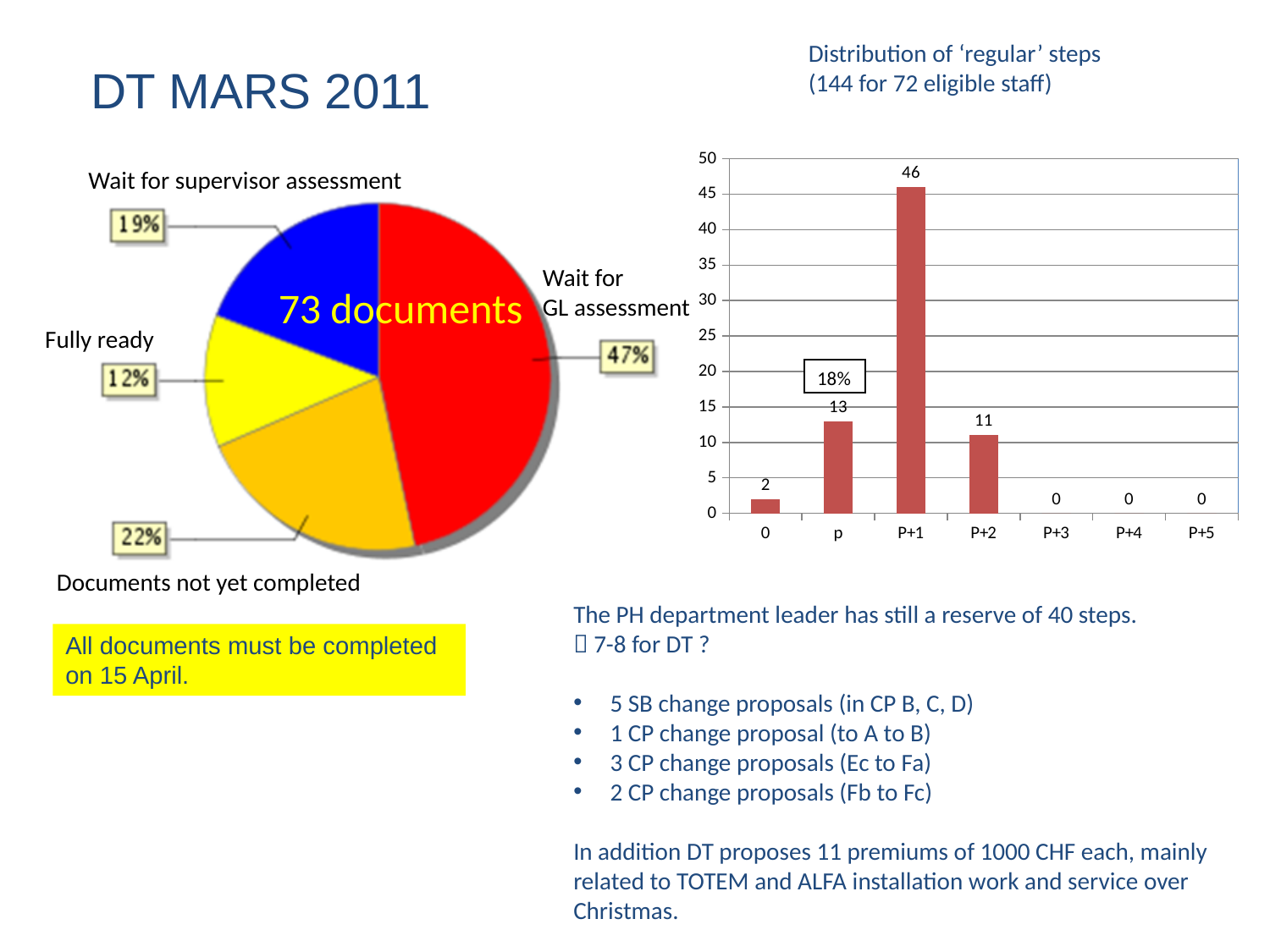
In the pie chart on the left, which category has the smallest share? Fully ready In the bar chart titled 'Distribution of regular steps', which is larger, the value for p or the value for P+2? p In the bar chart titled 'Distribution of regular steps', what is the difference between the values for P+1 and p? 33 In the pie chart on the left, what share of documents is 'Wait for GL assessment'? 47% In the bar chart titled 'Distribution of regular steps', which category has the highest value? P+1 In the bar chart titled 'Distribution of regular steps', what is the value for p? 13 In the bar chart titled 'Distribution of regular steps', what is the value for P+1? 46 In the pie chart on the left, what share of documents is 'Fully ready'? 12% In the bar chart titled 'Distribution of regular steps', what is the value for P+2? 11 What kind of chart is the chart on the left of the slide? pie chart What kind of chart is the chart on the right of the slide? bar chart In the bar chart titled 'Distribution of regular steps', how many categories are shown on the x axis? 7